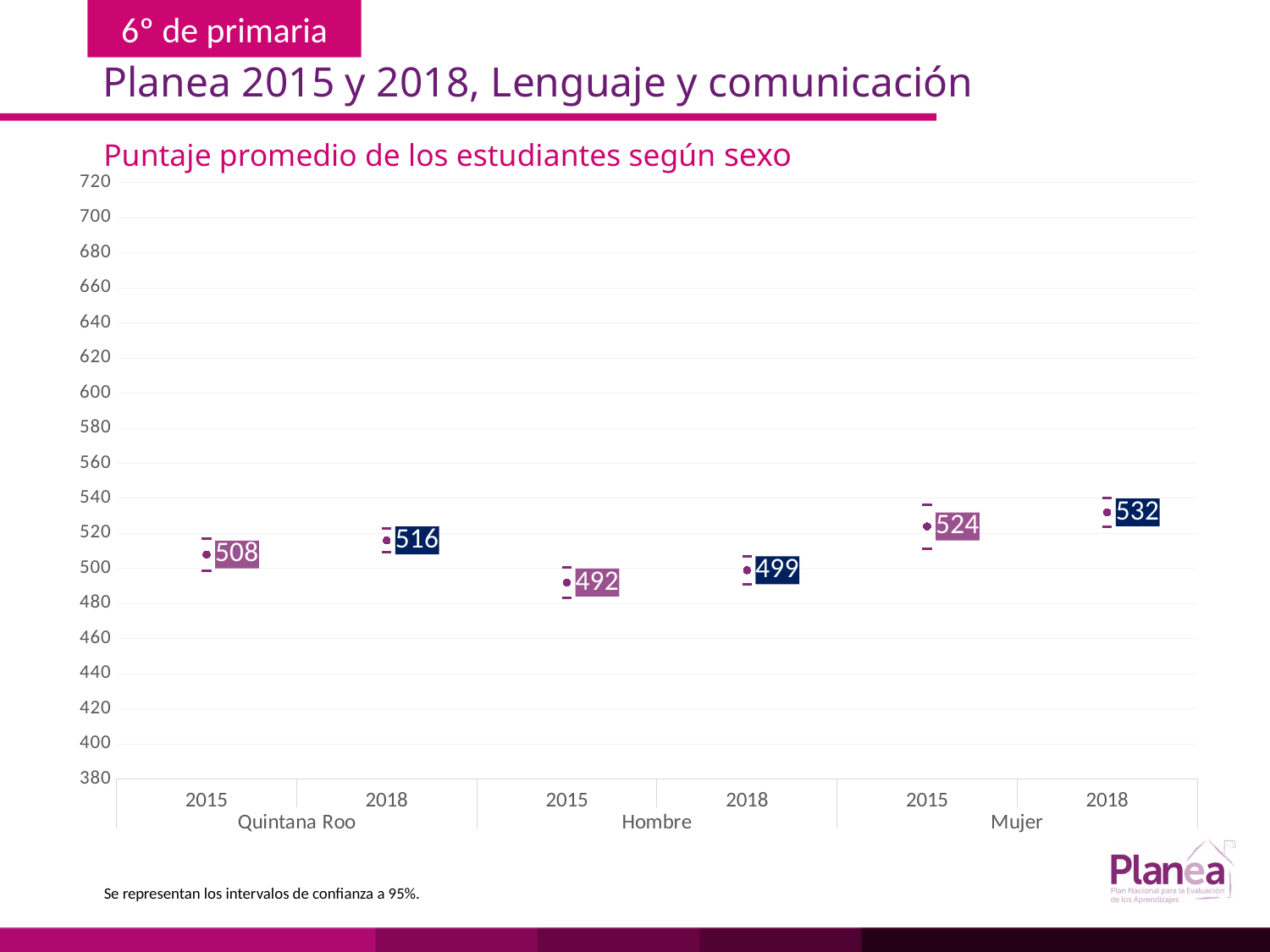
Which is larger, the Quintana Roo score in 2018 or the Hombre score in 2018? Quintana Roo 2018 What is the average score for Mujer in 2018? 532 What is the title of the chart? Puntaje promedio de los estudiantes según sexo Is the Hombre 2015 average score greater or less than 500? less What is the average score for Hombre in 2018? 499 What is the average score for Quintana Roo in 2015? 508 What is the difference between the Mujer and Hombre average scores in 2018? 33 Which group and year has the lowest average score? Hombre 2015 By how many points did the Mujer average score change from 2015 to 2018? 8 Do the average scores rise or fall from 2015 to 2018 for each group? rise How many data points are plotted on the chart? 6 Which group and year has the highest average score? Mujer 2018